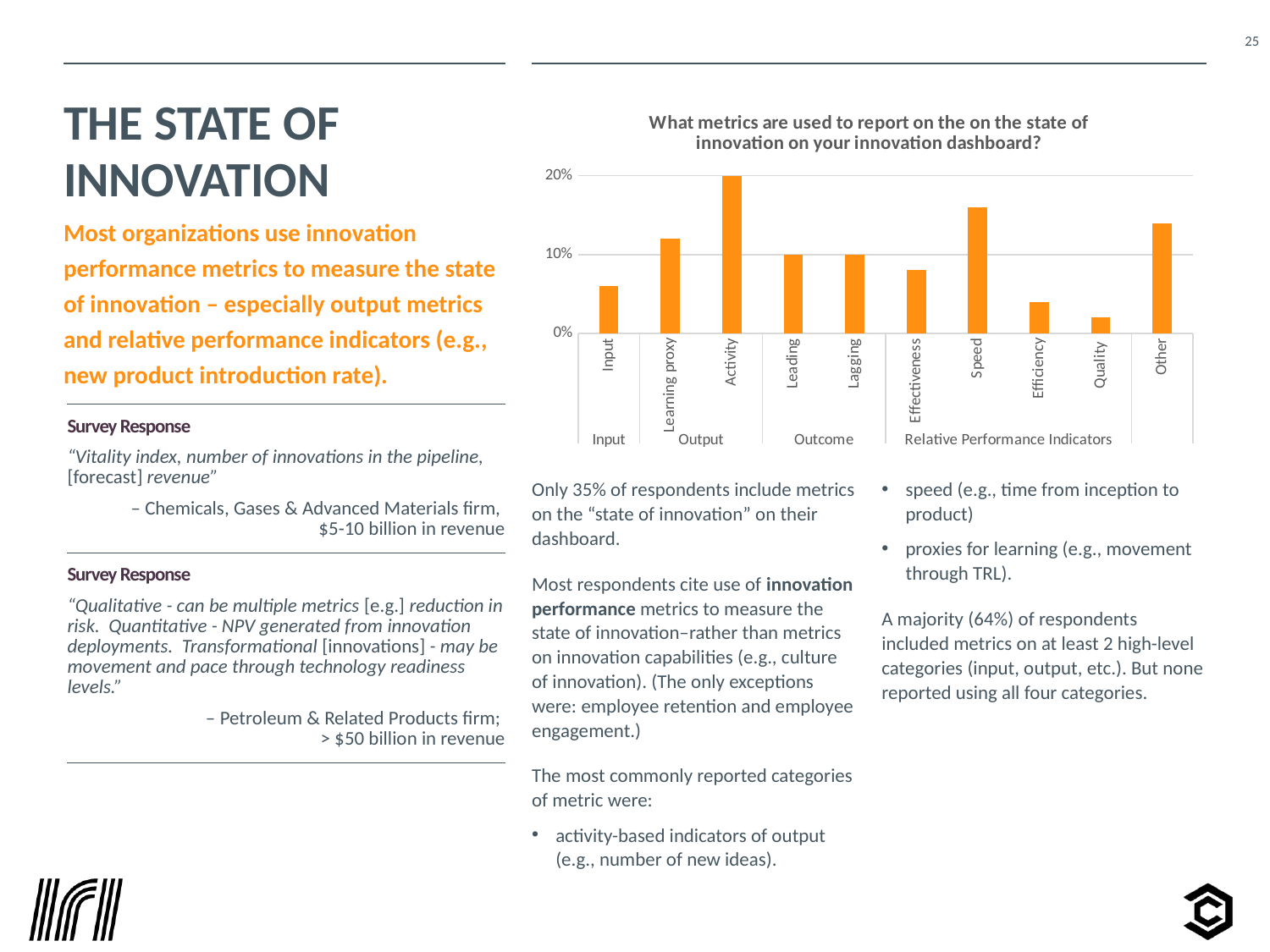
Is the value for Efficiency greater or less than 10%? less How many bars (metric categories) are plotted in the chart? 10 What is the title of the chart? What metrics are used to report on the on the state of innovation on your innovation dashboard? Is the value for Other greater or less than 10%? greater Which metric has the lowest bar in the chart? Quality Which is larger, the value for Learning proxy or the value for Input? Learning proxy Is the value for Speed greater or less than 10%? greater What kind of chart is shown on the slide? bar chart What value does the Activity bar reach on the axis? 20% Which metric has the highest bar in the chart? Activity How many high-level category groups are labelled along the bottom of the chart? 4